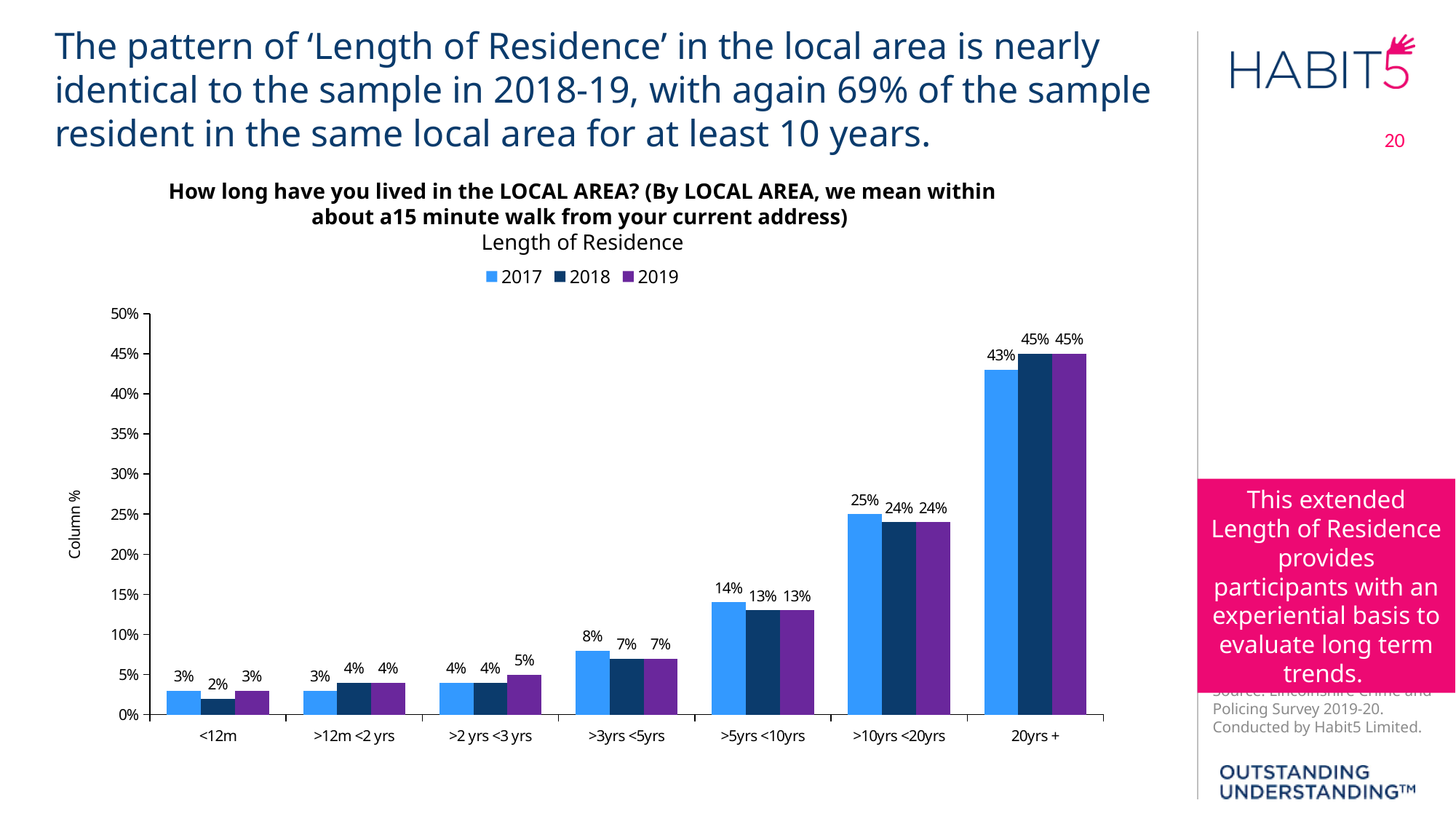
What is the value for 2019 in the '20yrs +' category? 45% Which category has the lowest value for the 2018 series? <12m How many categories are shown on the x axis? 7 In the '>10yrs <20yrs' category, which is larger: the 2017 value or the 2019 value? 2017 What kind of chart is shown on the slide? Bar chart What is the value for 2017 in the '>5yrs <10yrs' category? 14% What is the label of the y axis? Column % How many series does the legend list? 3 Which category has the highest value for the 2017 series? 20yrs + Do the 2019 values rise or fall moving from '<12m' to '20yrs +' along the x axis? Rise What is the difference between the 2018 and 2017 values in the '20yrs +' category? 2% What is the value for 2018 in the '<12m' category? 2%